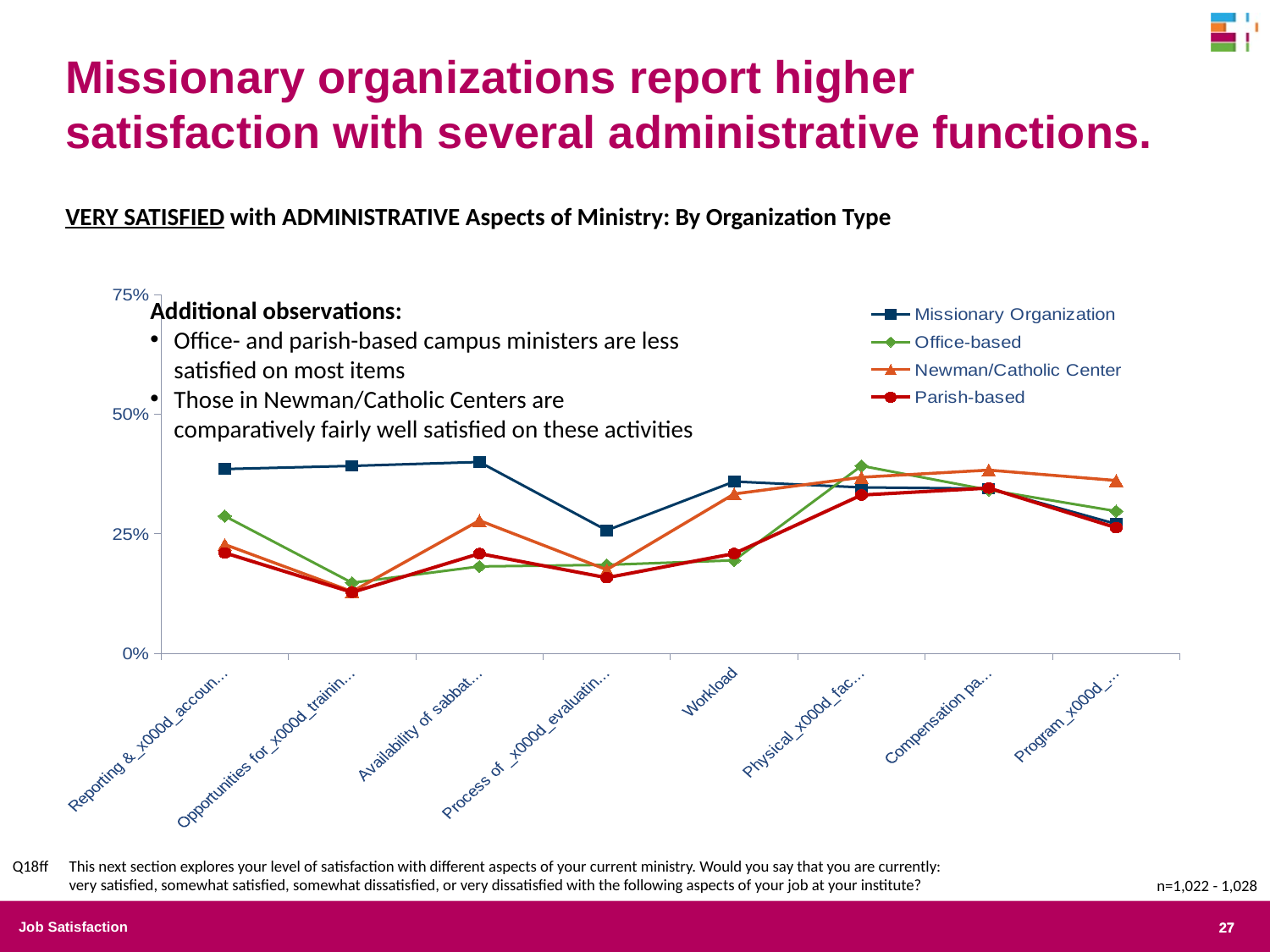
Is the Newman/Catholic Center value for Workload greater or less than 25%? greater For Workload, which is larger: the Missionary Organization value or the Office-based value? Missionary Organization Which series in the legend is drawn with square markers? Missionary Organization What is the title of the chart? VERY SATISFIED with ADMINISTRATIVE Aspects of Ministry: By Organization Type Does the Missionary Organization line end higher or lower at the last category than it starts at the first category? lower Is the Office-based value for Workload greater or less than 25%? less How many categories are plotted along the x axis? 8 What kind of chart is shown on the slide? line chart How many series does the legend list? 4 Is the Missionary Organization value for Workload greater or less than 25%? greater